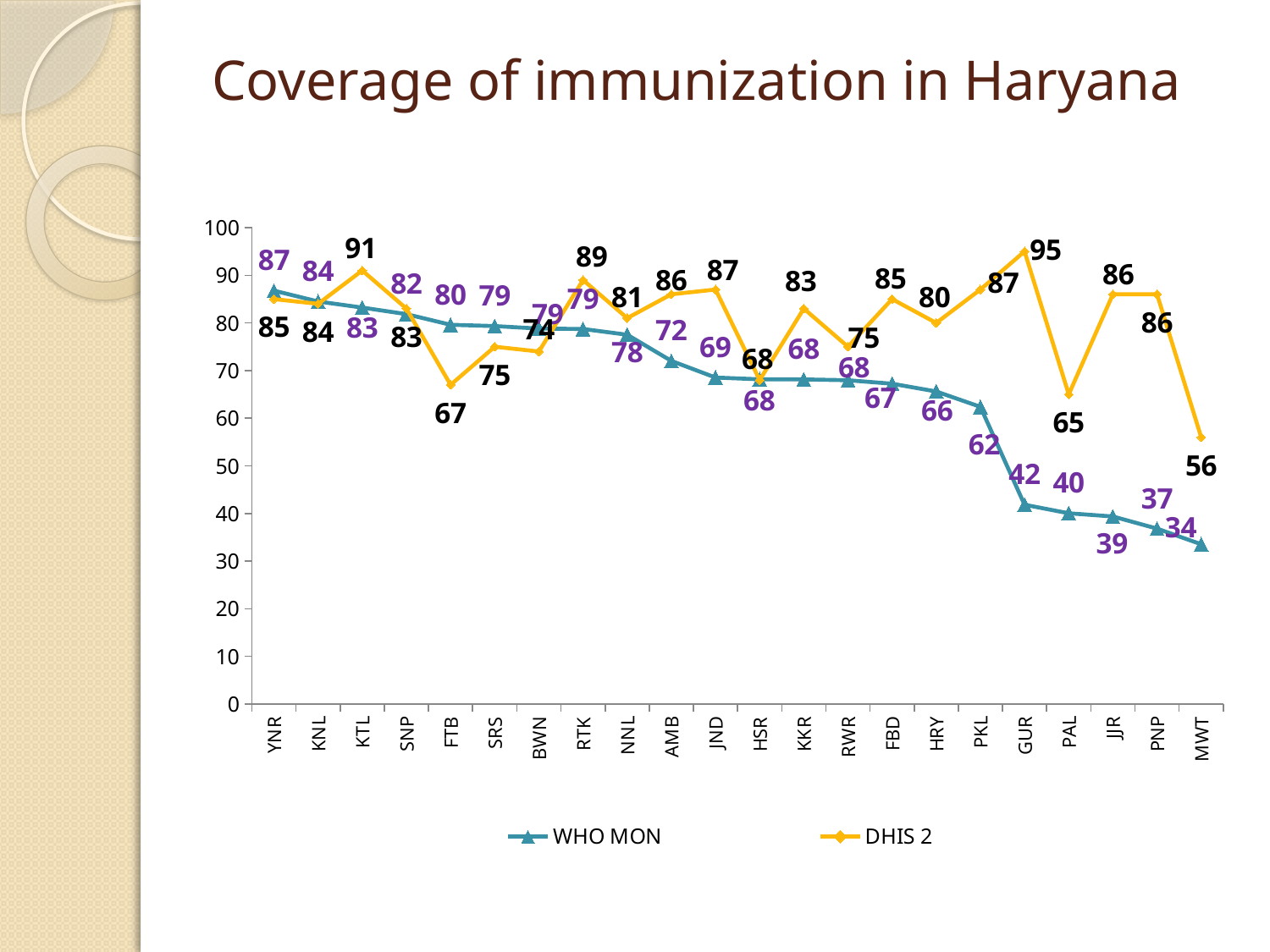
What is the difference between the DHIS 2 and WHO MON values for GUR? 53 How many districts are shown on the x axis? 22 What kind of chart is shown on the slide? Line chart What are the two series named in the legend? WHO MON and DHIS 2 What is the DHIS 2 value for KTL? 91 For FTB, which series has the higher value, WHO MON or DHIS 2? WHO MON What is the DHIS 2 value for MWT? 56 Does the WHO MON series generally rise or fall from YNR to MWT? Fall Which district has the highest DHIS 2 value? GUR What is the WHO MON value for GUR? 42 Which district has the lowest WHO MON value? MWT How many series does the legend list? 2